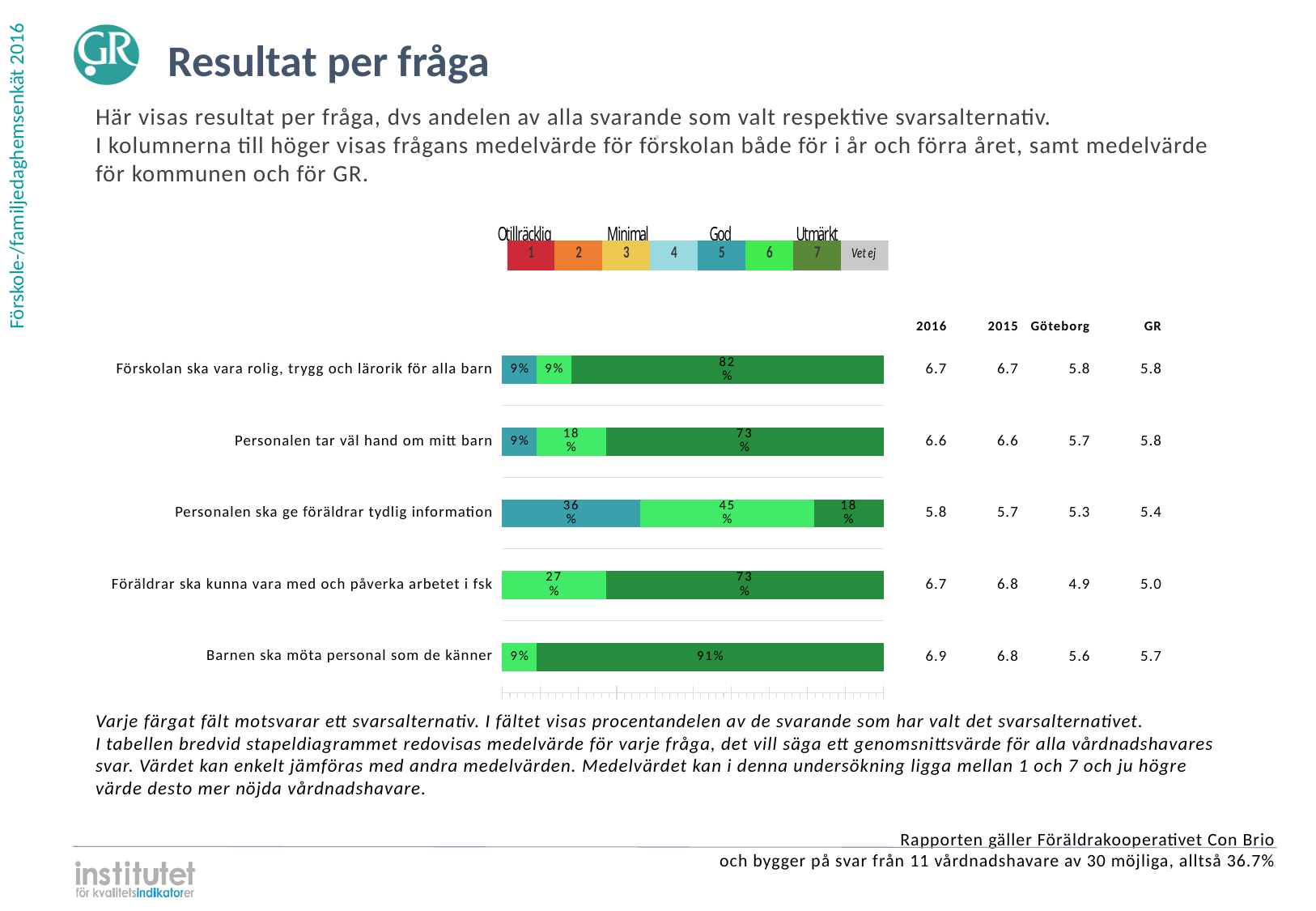
What kind of chart is used to show the results per question? Stacked bar chart What is the total of the labelled segments for "Förskolan ska vara rolig, trygg och lärorik för alla barn"? 100% Which question has the largest dark green (rating 7) segment? Barnen ska möta personal som de känner What percentage of respondents chose rating 7 (dark green) for "Barnen ska möta personal som de känner"? 91% How many questions (bars) are shown in the chart? 5 What percentage is shown for the light green (rating 6) segment of "Föräldrar ska kunna vara med och påverka arbetet i fsk"? 27% Which has the larger light green (rating 6) segment: "Personalen ska ge föräldrar tydlig information" or "Föräldrar ska kunna vara med och påverka arbetet i fsk"? Personalen ska ge föräldrar tydlig information What are the four rating group labels shown above the colour legend? Otillräcklig, Minimal, God, Utmärkt What is the 2016 mean value shown for "Barnen ska möta personal som de känner"? 6.9 How many percentage points larger is the rating 7 segment for "Förskolan ska vara rolig, trygg och lärorik för alla barn" than for "Personalen tar väl hand om mitt barn"? 9 percentage points What percentage is shown for the teal (rating 5) segment of "Personalen ska ge föräldrar tydlig information"? 36% Which question has the smallest dark green (rating 7) segment? Personalen ska ge föräldrar tydlig information